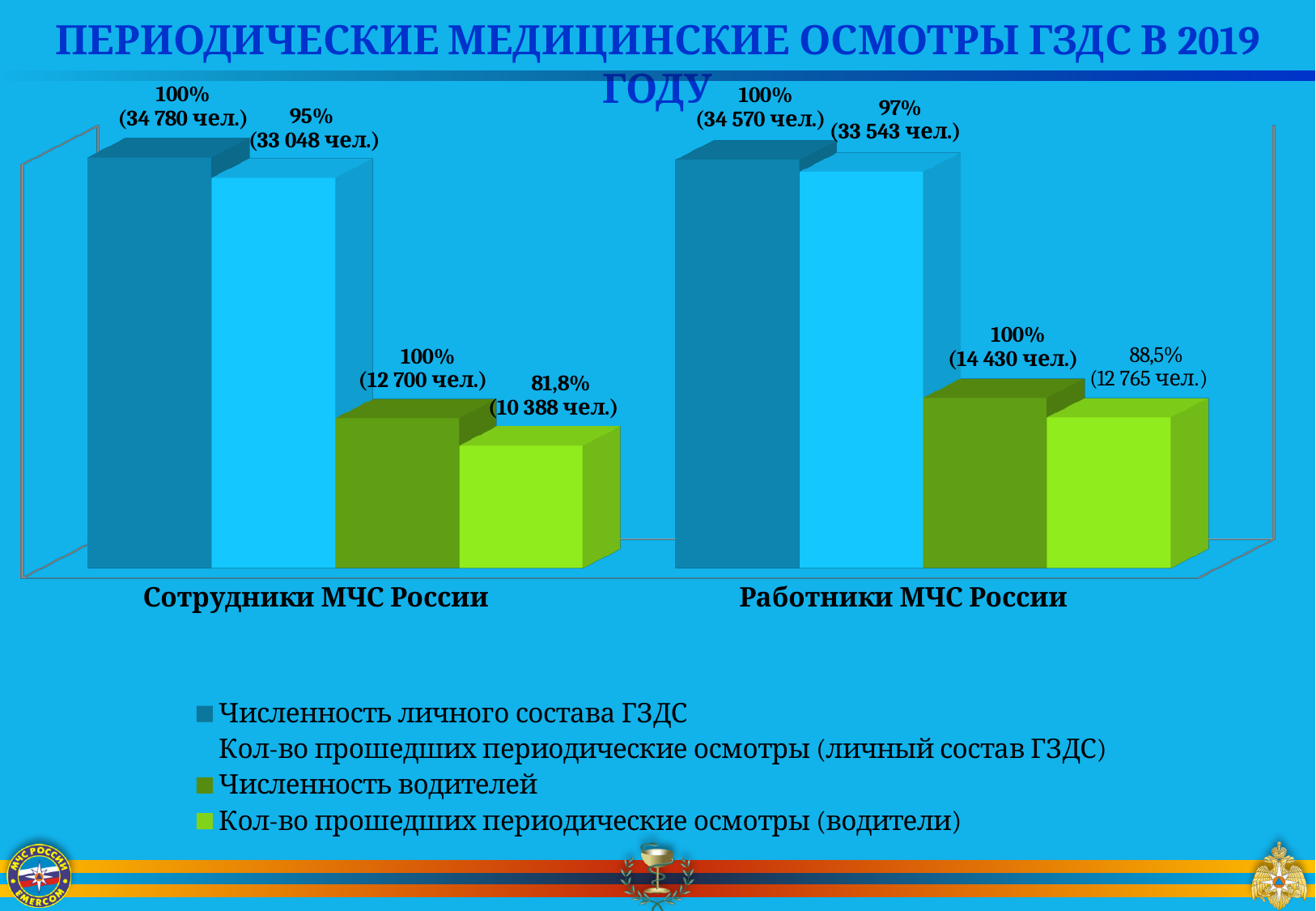
Which series has the highest value in the 'Работники МЧС России' category? Численность личного состава ГЗДС How many people are shown for 'Численность водителей' in the 'Работники МЧС России' category? 14 430 чел. What percentage is shown for 'Кол-во прошедших периодические осмотры (водители)' in the 'Сотрудники МЧС России' category? 81,8% What kind of chart is shown on the slide? bar chart How many categories are shown on the x axis of the chart? 2 What percentage is shown for 'Кол-во прошедших периодические осмотры (личный состав ГЗДС)' in the 'Работники МЧС России' category? 97% Which is larger: the number of drivers who passed periodic examinations among 'Сотрудники МЧС России' or among 'Работники МЧС России'? Работники МЧС России What is the title of the chart on the slide? ПЕРИОДИЧЕСКИЕ МЕДИЦИНСКИЕ ОСМОТРЫ ГЗДС В 2019 ГОДУ What is the difference in people between 'Численность водителей' and 'Кол-во прошедших периодические осмотры (водители)' in the 'Сотрудники МЧС России' category? 2 312 чел. Which series has the lowest value in the 'Сотрудники МЧС России' category? Кол-во прошедших периодические осмотры (водители) What is the data label for 'Численность личного состава ГЗДС' in the 'Сотрудники МЧС России' category? 100% (34 780 чел.) How many series does the legend list? 4